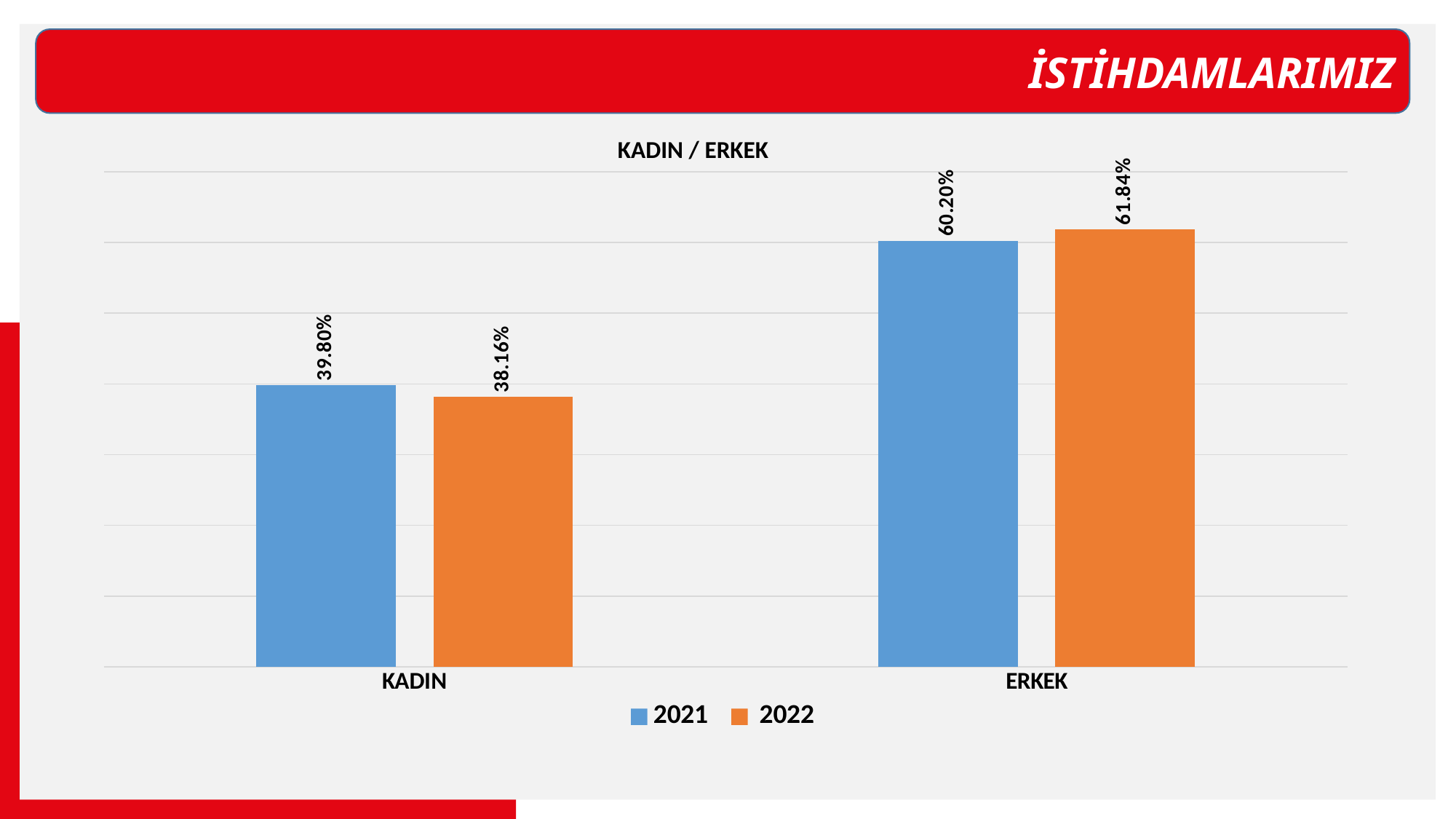
Which category has the lowest value in 2021? KADIN What is the difference between the 2022 and 2021 values for ERKEK? 1.64% How many series does the legend list? 2 What kind of chart is shown on the slide? Bar chart What is the value for ERKEK in 2021? 60.20% What is the value for ERKEK in 2022? 61.84% What is the value for KADIN in 2021? 39.80% What is the difference between the ERKEK and KADIN values in 2021? 20.40% Which is larger: the KADIN value in 2021 or the KADIN value in 2022? KADIN in 2021 Which category has the highest value in 2022? ERKEK How many categories are shown on the x axis? 2 What is the value for KADIN in 2022? 38.16%